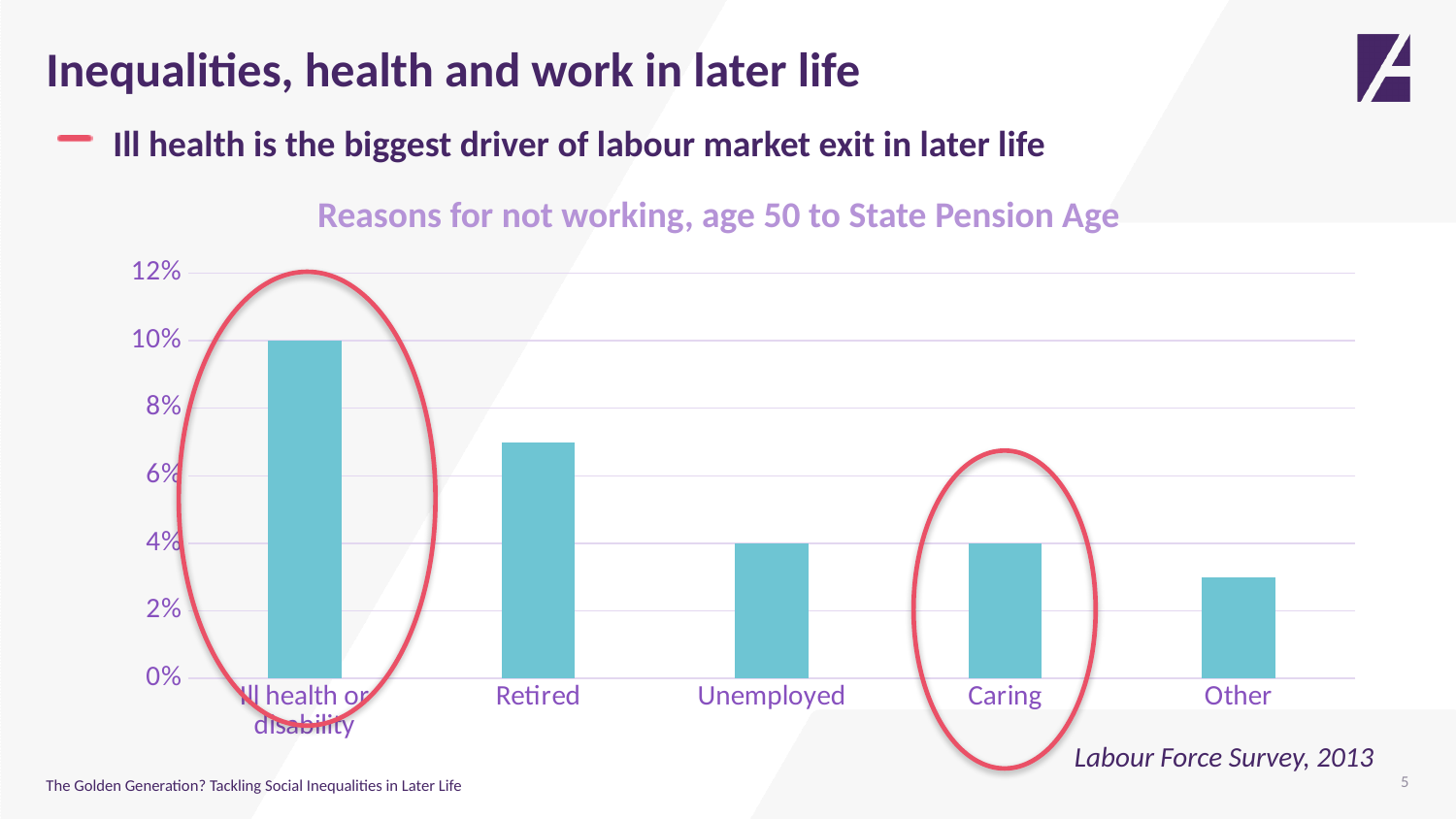
Which category has the highest value? Ill health or disability What is the value for Ill health or disability? 10% Which is larger, the value for Retired or the value for Unemployed? Retired What is the value for Unemployed? 4% Is the value for Retired greater or less than 6%? greater What is the value for Caring? 4% How many categories are shown on the x axis of the chart? 5 What is the title of the chart? Reasons for not working, age 50 to State Pension Age What type of chart is shown on the slide? Bar chart What is the difference between the values for Ill health or disability and Caring? 6% Which category has the lowest value? Other Is the value for Other greater or less than 4%? less